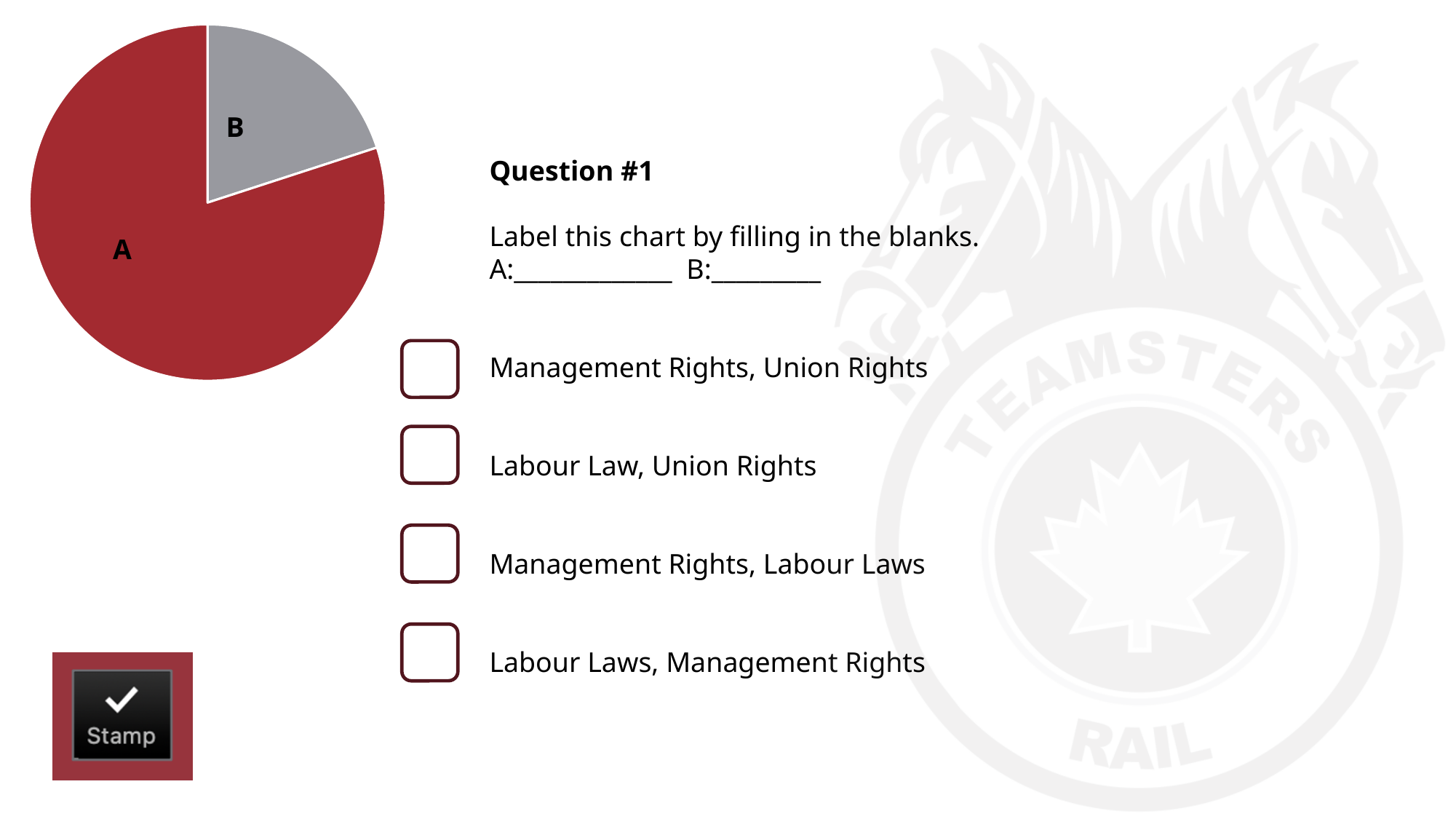
What colour is slice A in the pie chart? Red Which slice of the pie chart is the largest? A What kind of chart is shown on the slide? Pie chart What colour is slice B in the pie chart? Grey Which slice of the pie chart is the smallest? B How many slices does the pie chart have? 2 Does slice A take up more or less than half of the pie chart? More Which slice is larger in the pie chart, A or B? A